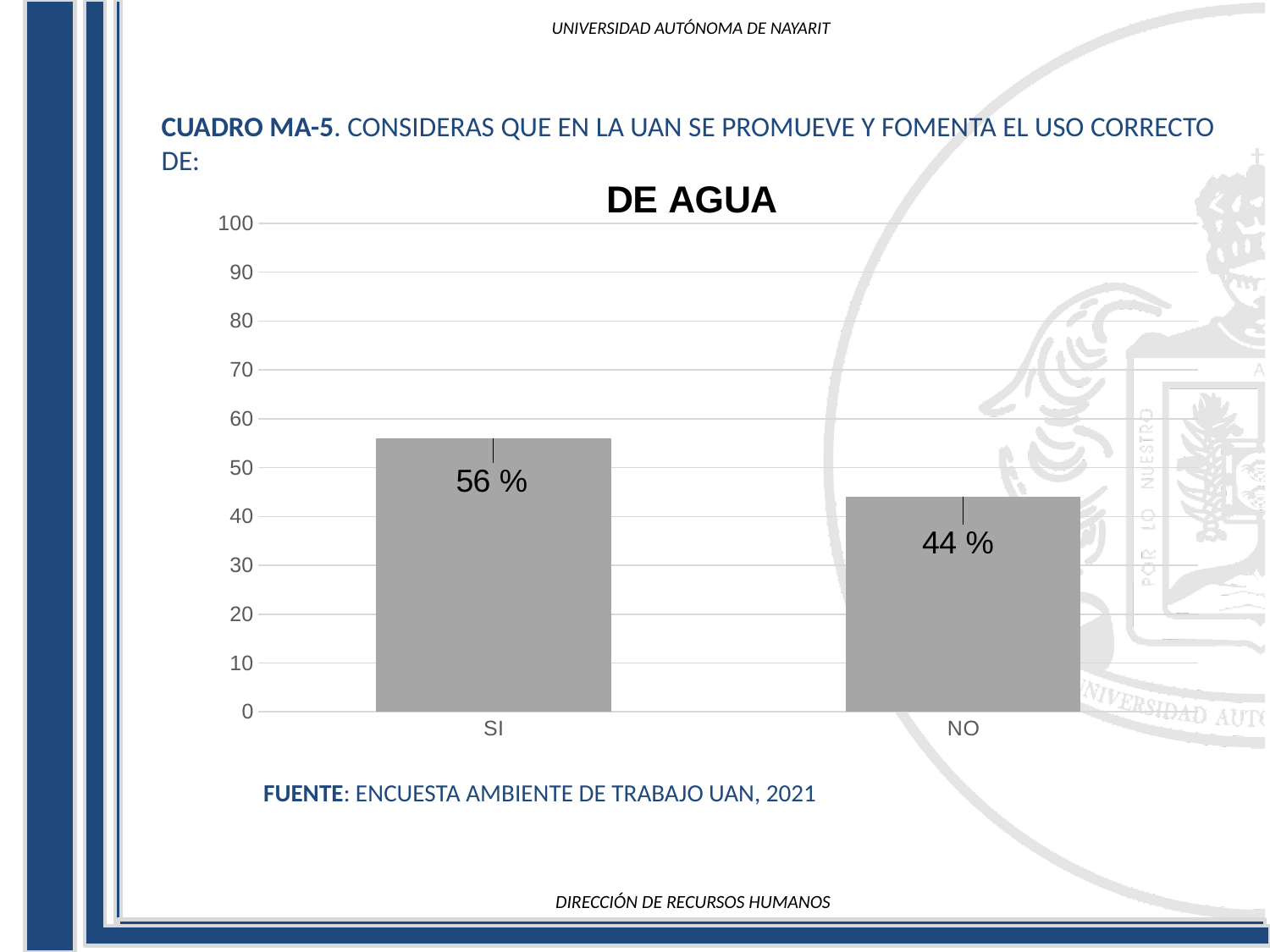
What is the value for NO? 44 % How many categories are shown on the x axis? 2 What kind of chart is shown? bar chart What is the maximum value shown on the y axis? 100 Is the value for NO greater or less than 50? less What is the title of the chart? DE AGUA Is the value for SI greater or less than 50? greater What is the difference between the values for SI and NO? 12 % Which category has the lowest value? NO What is the value for SI? 56 % Which is larger, the value for SI or the value for NO? SI Which category has the highest value? SI